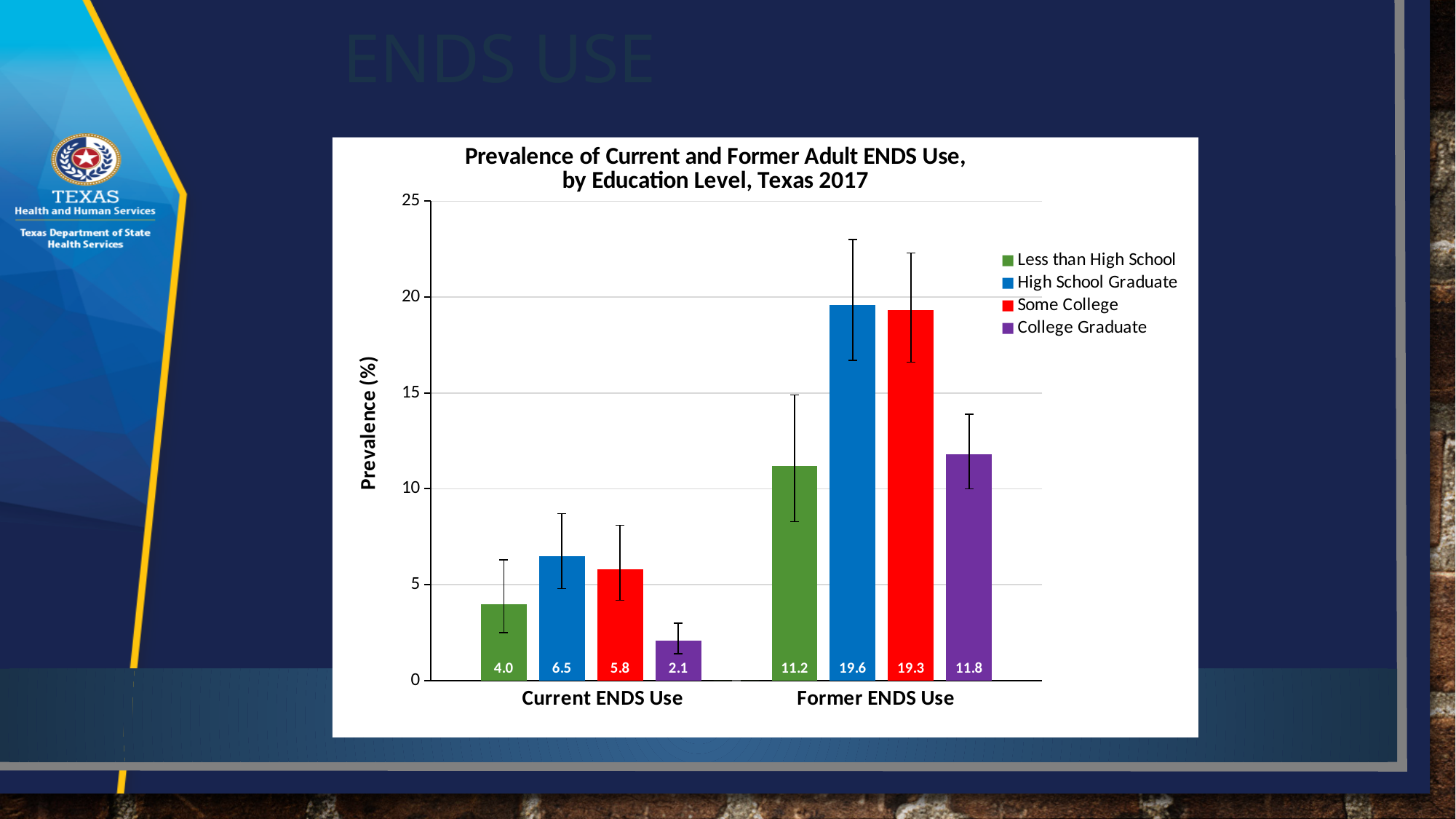
What kind of chart is shown on the slide? Bar chart How many categories are shown on the x axis? 2 What is the label of the y axis? Prevalence (%) What is the difference between the Former ENDS Use prevalence for Some College and for College Graduate? 7.5 Which education level has the lowest prevalence of Current ENDS Use? College Graduate Which education level has the highest prevalence of Former ENDS Use? High School Graduate What is the prevalence of Former ENDS Use for College Graduate? 11.8 What is the prevalence of Current ENDS Use for High School Graduate? 6.5 Which is larger: Current ENDS Use for Some College or Current ENDS Use for High School Graduate? High School Graduate Is the Former ENDS Use value for Less than High School greater or less than 10? greater How many series does the legend list? 4 What is the prevalence of Current ENDS Use for Less than High School? 4.0